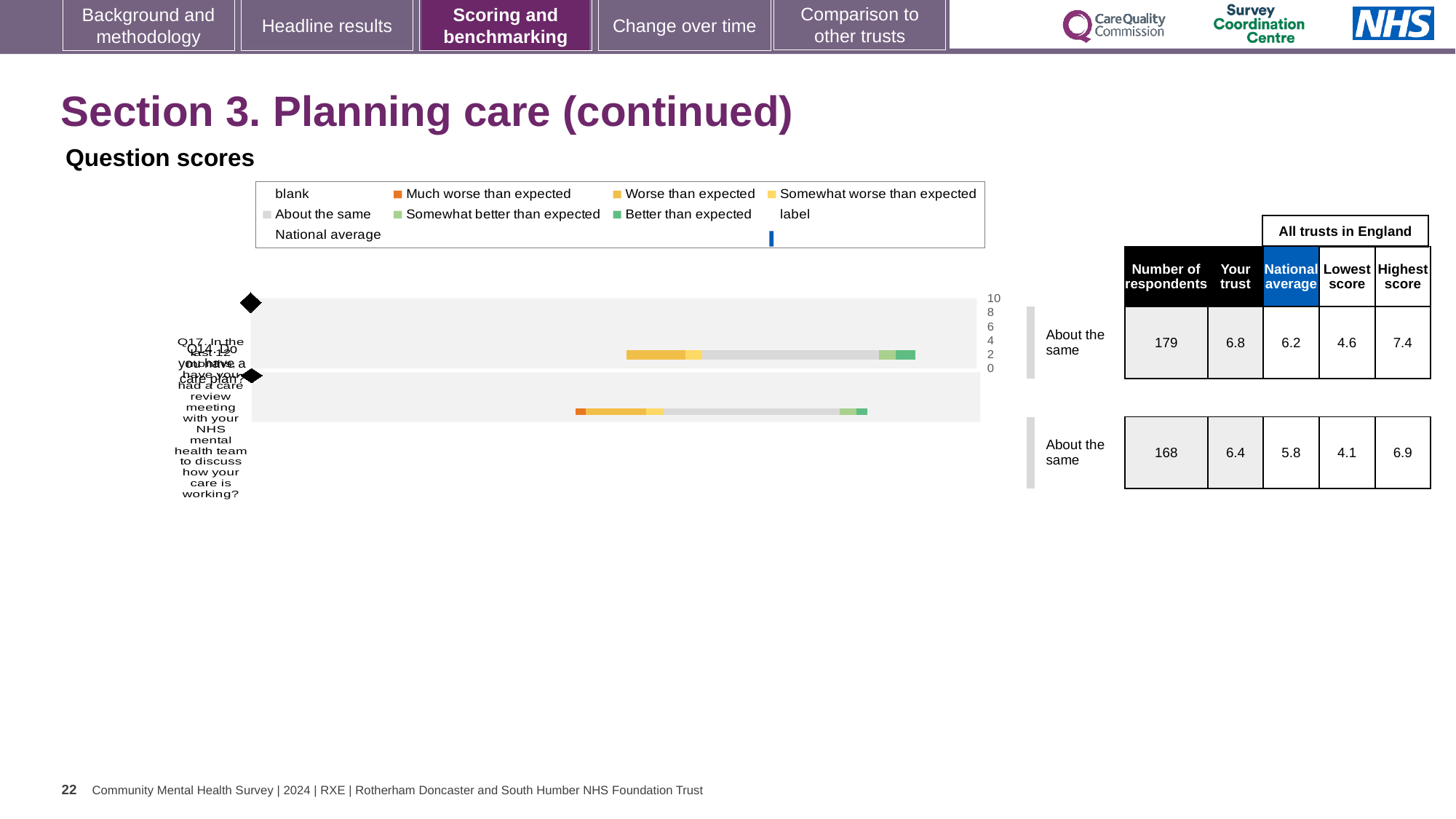
What is the highest score among all trusts in England for Q14? 7.4 What is the difference between the highest and lowest scores in England for Q17? 2.8 How many question bars are plotted in the chart? 2 Which question has the higher 'Your trust' score, Q14 or Q17? Q14 What is the 'Your trust' score for Q14 (Do you have a care plan?)? 6.8 What kind of chart is shown under 'Question scores'? bar chart By how much does the trust's score for Q14 exceed the national average for Q14? 0.6 How many respondents answered Q14? 179 What benchmark category is shown for both Q14 and Q17? About the same Which question had more respondents, Q14 or Q17? Q14 What is the national average score for Q17 (care review meeting in the last 12 months)? 5.8 What is the lowest score among all trusts in England for Q17? 4.1